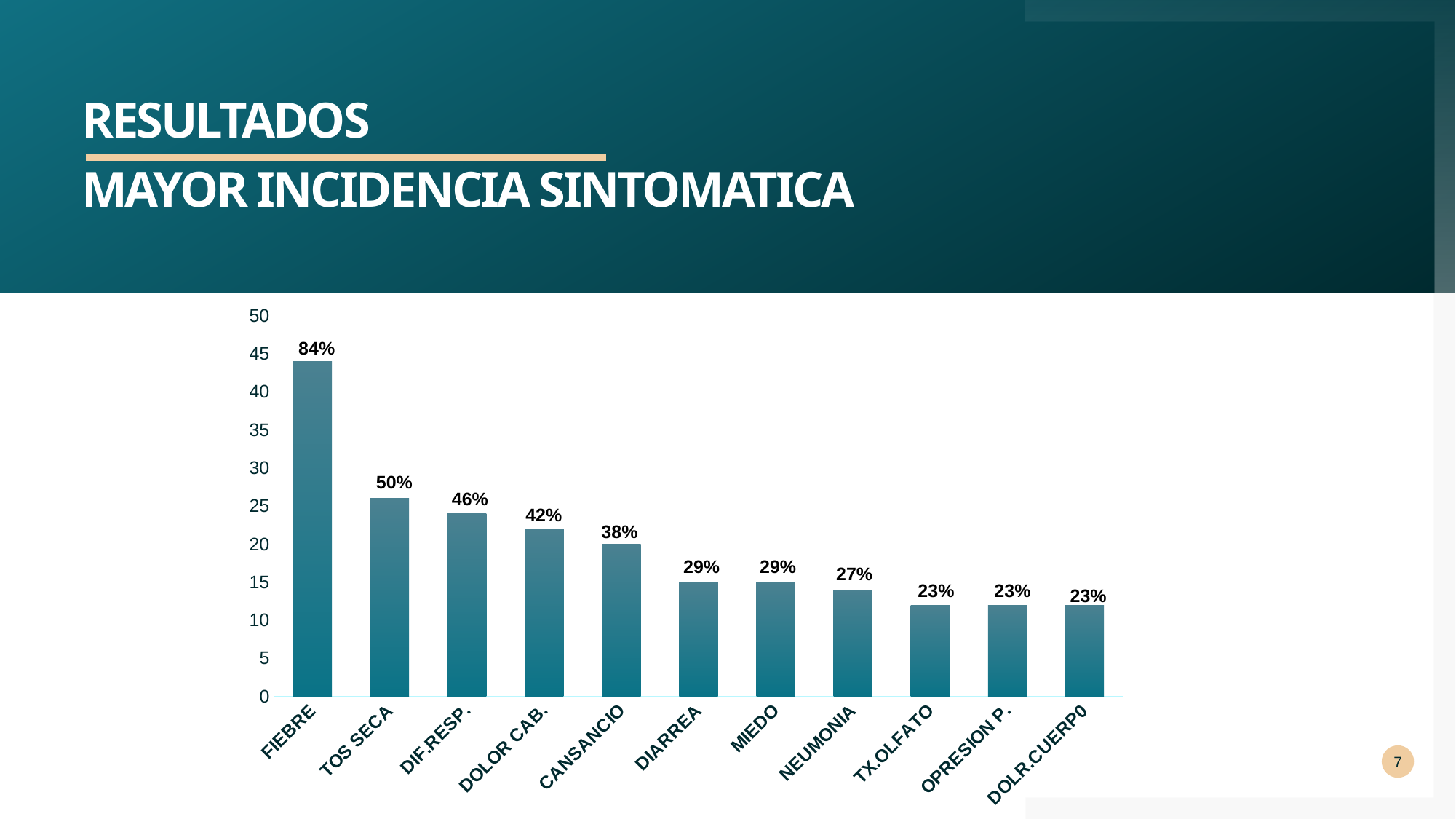
Which category has the highest value in the chart? FIEBRE What kind of chart is shown on the slide? Bar chart Do the values rise or fall moving from left to right along the x axis? Fall What is the difference between the data labels for FIEBRE and TOS SECA? 34% Is the bar for FIEBRE greater or less than 40 on the vertical axis? greater What is the data label shown for NEUMONIA? 27% Which is larger, the value for DIF.RESP. or the value for DOLOR CAB.? DIF.RESP. What is the data label shown for FIEBRE? 84% What is the data label shown for TOS SECA? 50% What is the data label shown for CANSANCIO? 38% What is the subtitle of the slide above the chart? MAYOR INCIDENCIA SINTOMATICA How many symptom categories are plotted in the chart? 11